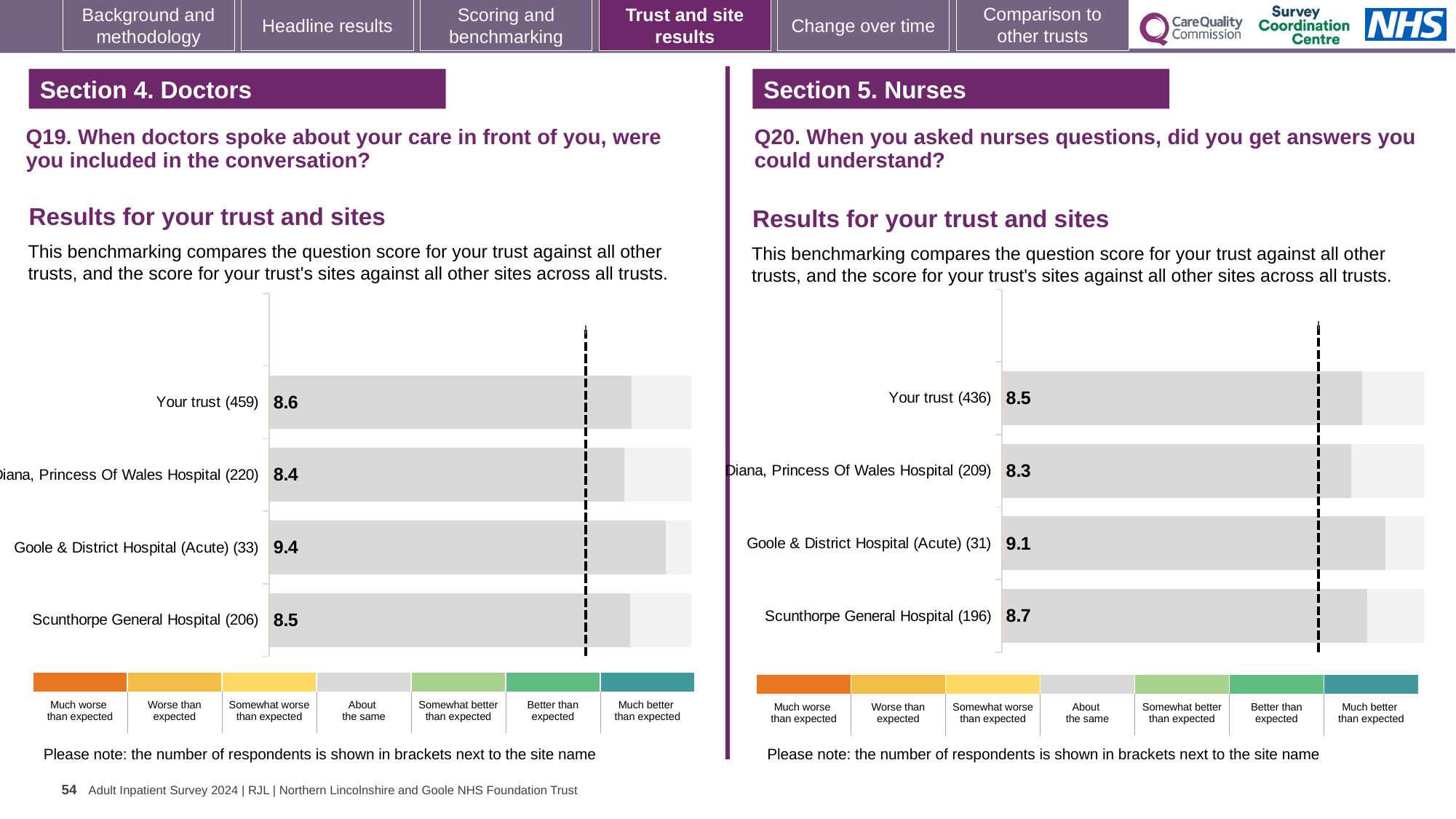
In the Q20 chart (Section 5. Nurses), what is the score for Diana, Princess Of Wales Hospital? 8.3 In the Q19 chart (Section 4. Doctors), what is the score for Goole & District Hospital (Acute)? 9.4 In the Q19 chart (Section 4. Doctors), what is the score for Your trust? 8.6 In the Q19 chart (Section 4. Doctors), what is the difference between the scores for Goole & District Hospital (Acute) and Scunthorpe General Hospital? 0.9 What type of chart is used in the Q20 chart (Section 5. Nurses)? Bar chart In the Q19 chart (Section 4. Doctors), which site has the highest score? Goole & District Hospital (Acute) How many bars are shown in the Q19 chart (Section 4. Doctors)? 4 In the Q20 chart (Section 5. Nurses), which is larger: the score for Scunthorpe General Hospital or the score for Your trust? Scunthorpe General Hospital In the Q20 chart (Section 5. Nurses), what is the score for Scunthorpe General Hospital? 8.7 In the Q20 chart (Section 5. Nurses), which site has the highest score? Goole & District Hospital (Acute) In the Q19 chart (Section 4. Doctors), which bar has the lowest score? Diana, Princess Of Wales Hospital In the Q20 chart (Section 5. Nurses), what is the difference between the scores for Your trust and Diana, Princess Of Wales Hospital? 0.2